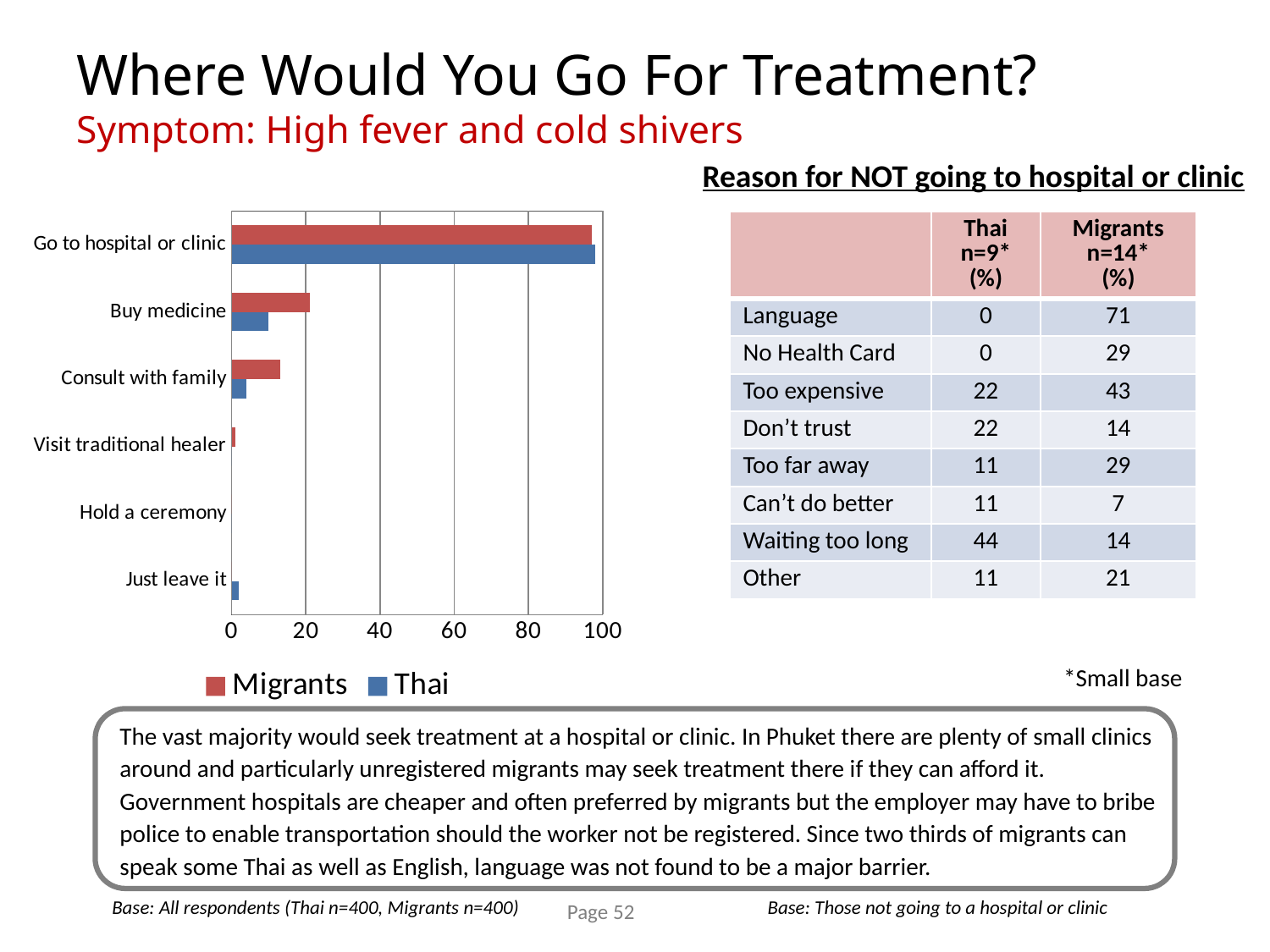
Is the Thai value for Buy medicine greater or less than 20? less For Buy medicine, which series has the larger value, Migrants or Thai? Migrants What colour are the bars for the Migrants series? red Which category has the highest value for Thai? Go to hospital or clinic How many categories are plotted on the chart? 6 Is the Migrants value for Go to hospital or clinic greater or less than 80? greater Is the Migrants value for Buy medicine greater or less than 40? less Which category has the highest value for Migrants? Go to hospital or clinic What kind of chart is shown on the slide? bar chart For Consult with family, which series has the larger value, Migrants or Thai? Migrants What are the two series named in the chart's legend? Migrants and Thai How many series does the chart's legend list? 2